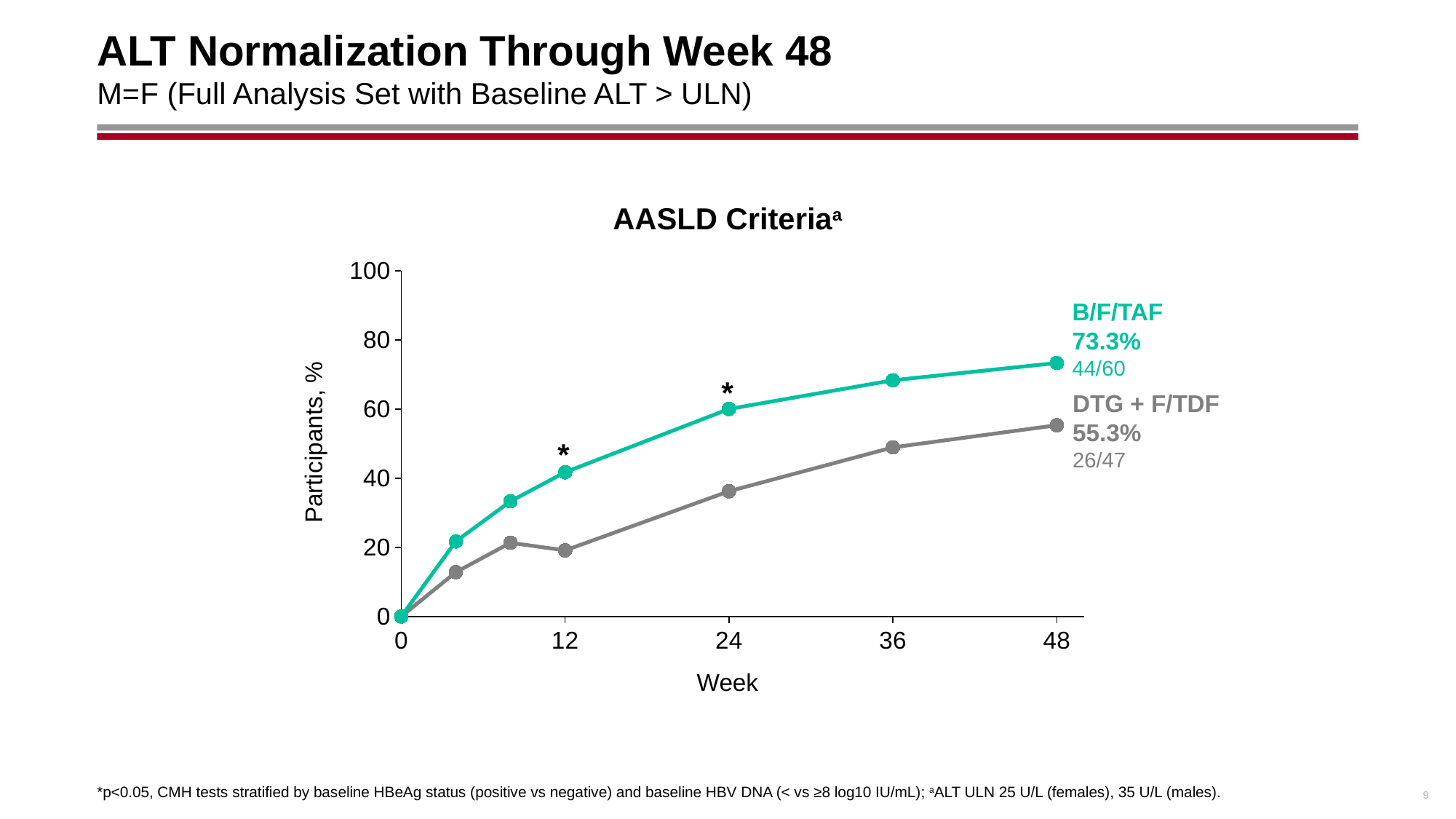
What percentage of participants on DTG + F/TDF achieved ALT normalization at week 48? 55.3% How many treatment arms (series) are plotted on the chart? 2 What is the label on the y-axis of the chart? Participants, % What percentage of participants on B/F/TAF achieved ALT normalization at week 48? 73.3% Does the B/F/TAF line rise or fall from week 0 to week 48? rise What fraction of participants is shown for DTG + F/TDF at week 48? 26/47 What fraction of participants is shown for B/F/TAF at week 48? 44/60 What kind of chart is shown on the slide? line chart What is the difference in percentage points between B/F/TAF and DTG + F/TDF at week 48? 18.0 percentage points Which treatment arm has the higher percentage of participants with ALT normalization at week 48? B/F/TAF Is the value for B/F/TAF at week 24 greater or less than 40? greater Is the value for DTG + F/TDF at week 24 greater or less than 40? less